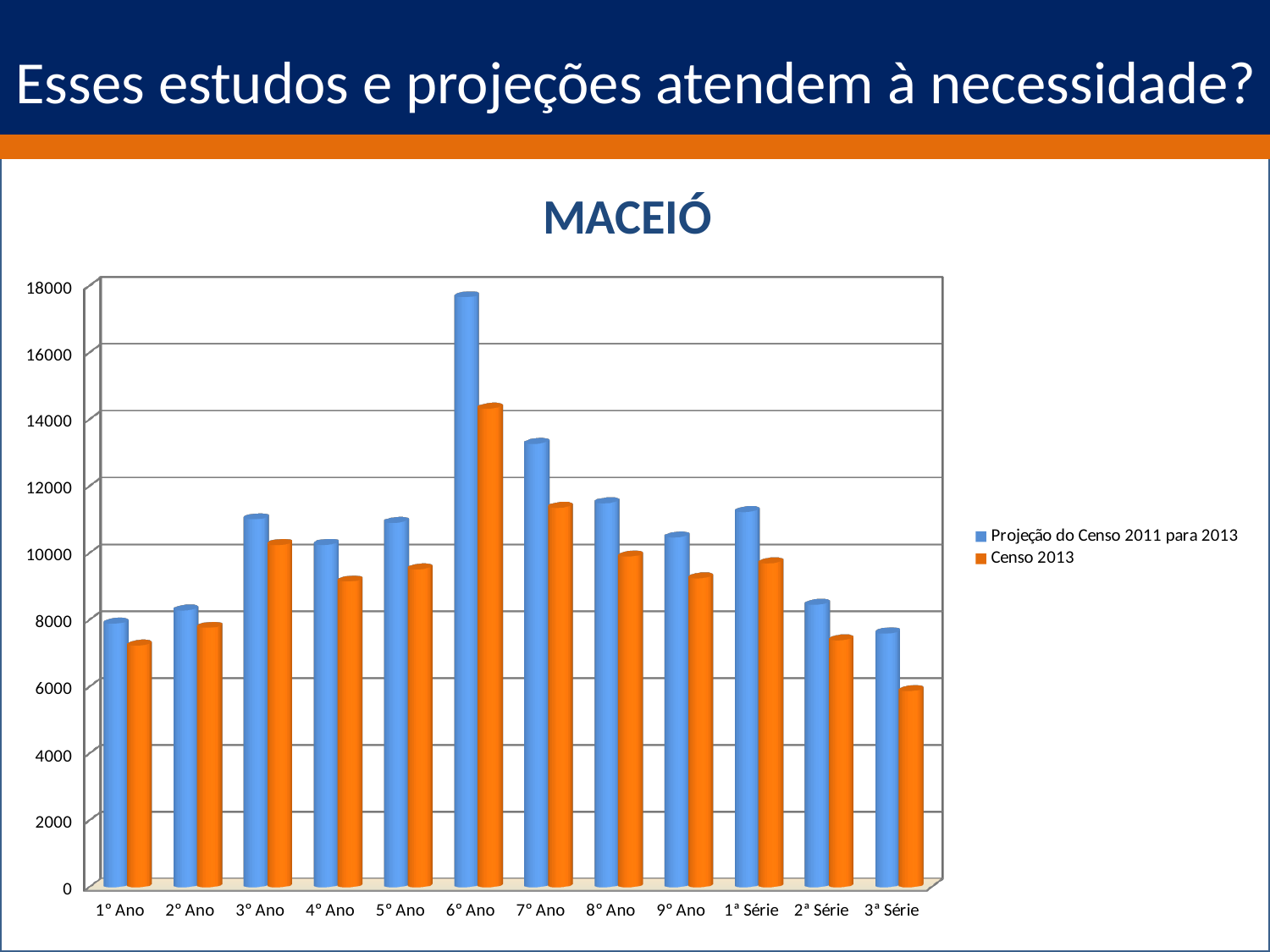
Which is larger for Censo 2013: the value for 7° Ano or the value for 8° Ano? 7° Ano Which category has the highest value for Projeção do Censo 2011 para 2013? 6° Ano Is the Censo 2013 value for 1° Ano greater or less than 8000? less How many categories are shown along the x axis? 12 Which category has the highest value for Censo 2013? 6° Ano Is the Projeção do Censo 2011 para 2013 value for 6° Ano greater or less than 16000? greater What is the title of the chart? MACEIÓ How many series does the legend list? 2 Which category has the lowest value for Censo 2013? 3ª Série For 6° Ano, which series has the larger value: Projeção do Censo 2011 para 2013 or Censo 2013? Projeção do Censo 2011 para 2013 What kind of chart is shown on the slide? bar chart Is the Censo 2013 value for 6° Ano greater or less than 12000? greater